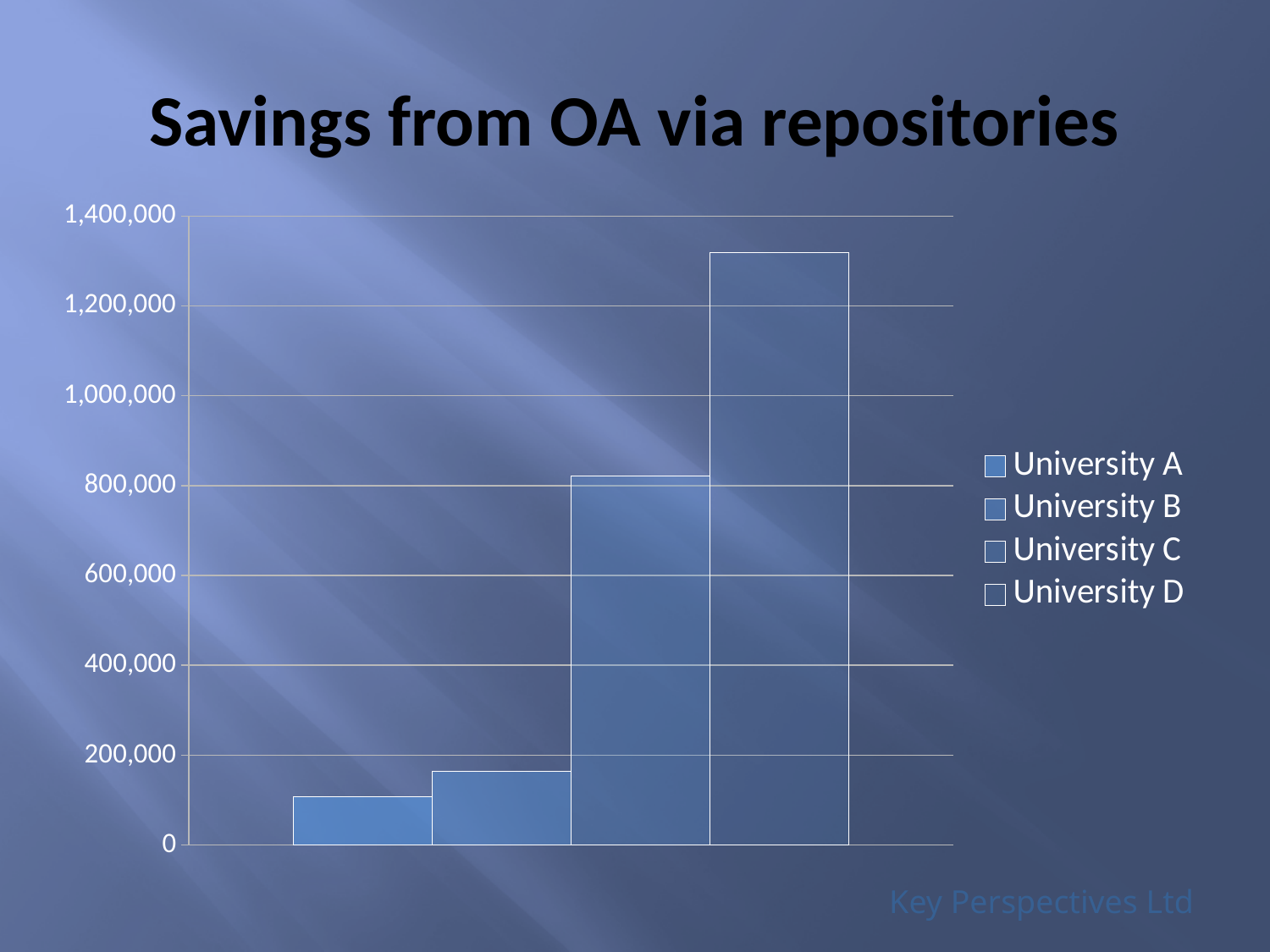
Is the value for University D greater or less than 1,200,000? greater Which university has the highest savings? University D How many series does the legend list? 4 What is the highest value shown on the vertical axis? 1,400,000 Which university has the lowest savings? University A Do the bar values rise or fall from left to right across the chart? rise What is the title of the chart? Savings from OA via repositories How many bars are plotted in the chart? 4 What kind of chart is shown on the slide? bar chart Which is larger, the value for University C or University B? University C Is the value for University C greater or less than 1,000,000? less Is the value for University A greater or less than 200,000? less